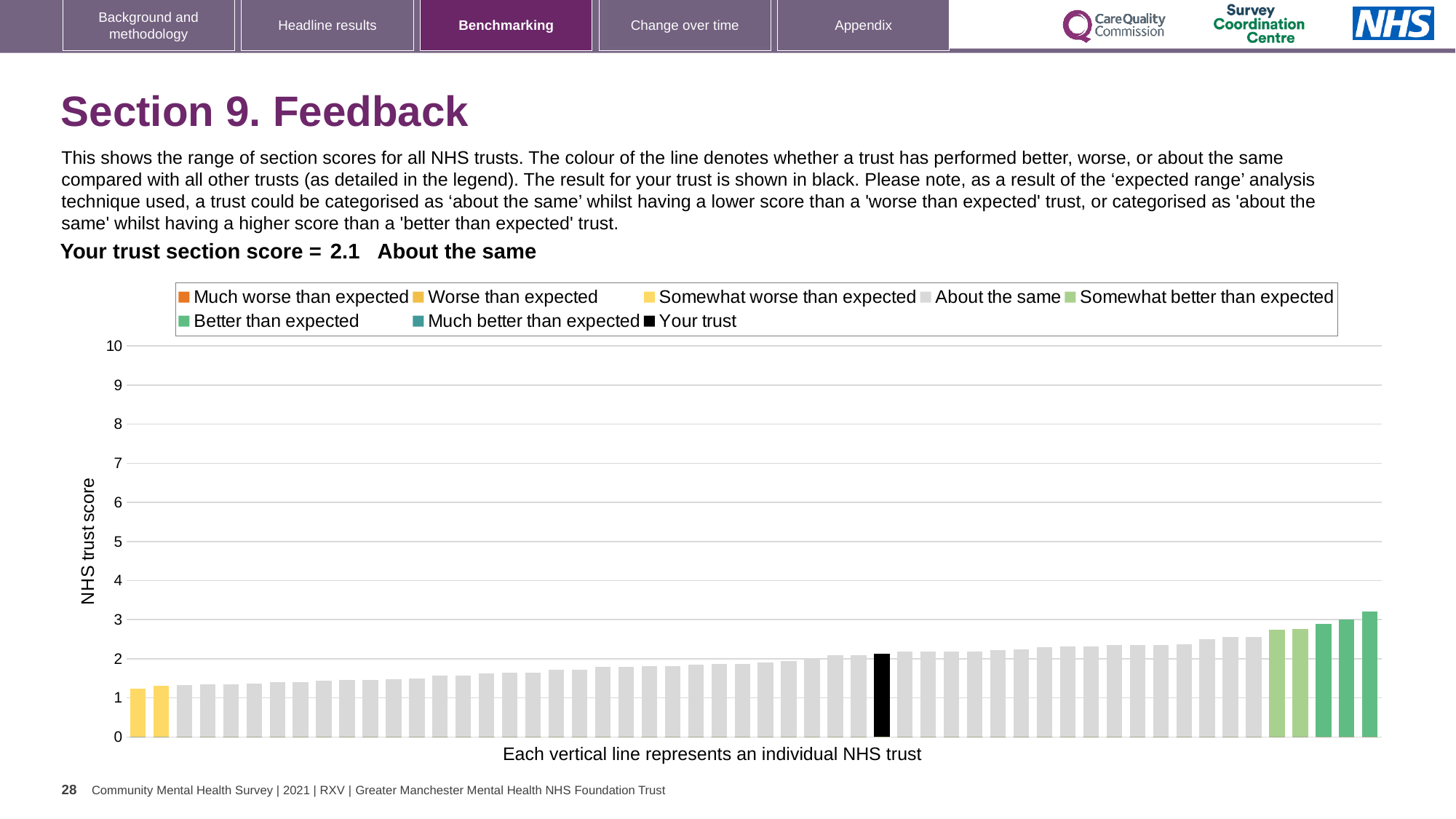
How many entries does the chart legend list? 8 What kind of chart is shown on the slide? Bar chart Do the bar values rise or fall from left to right along the x axis? Rise What colour is used for the bar representing your trust? Black What is the label on the vertical axis of the chart? NHS trust score Which is larger, the leftmost bar or the rightmost bar? The rightmost bar What is the section score for your trust shown on the slide? 2.1 Is the value for your trust (the black bar) greater or less than 3? less Is the highest bar in the chart greater or less than 5? less Which category is your trust's section score placed in? About the same Is the lowest bar in the chart greater or less than 2? less